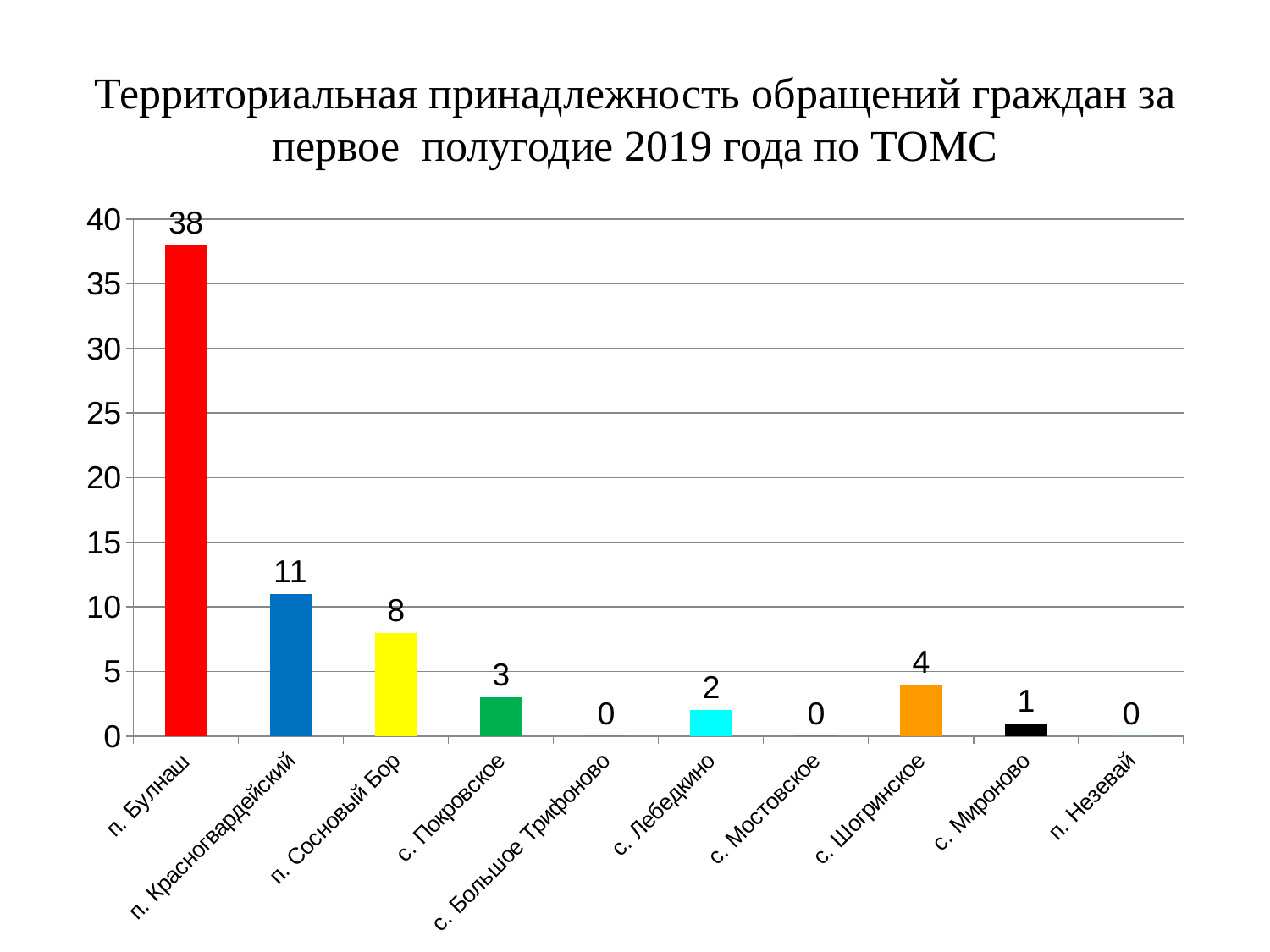
How many categories have a value of 0? 3 Is the value for п. Булнаш greater or less than 35? greater What is the value for п. Булнаш? 38 What is the value for с. Лебедкино? 2 What is the value for с. Шогринское? 4 What kind of chart is shown on the slide? bar chart What is the value for п. Красногвардейский? 11 Which is larger, the value for с. Шогринское or the value for с. Покровское? с. Шогринское Which category has the highest value? п. Булнаш What is the difference between the values for п. Сосновый Бор and с. Покровское? 5 How many categories are shown on the x axis? 10 What is the difference between the values for п. Булнаш and п. Красногвардейский? 27